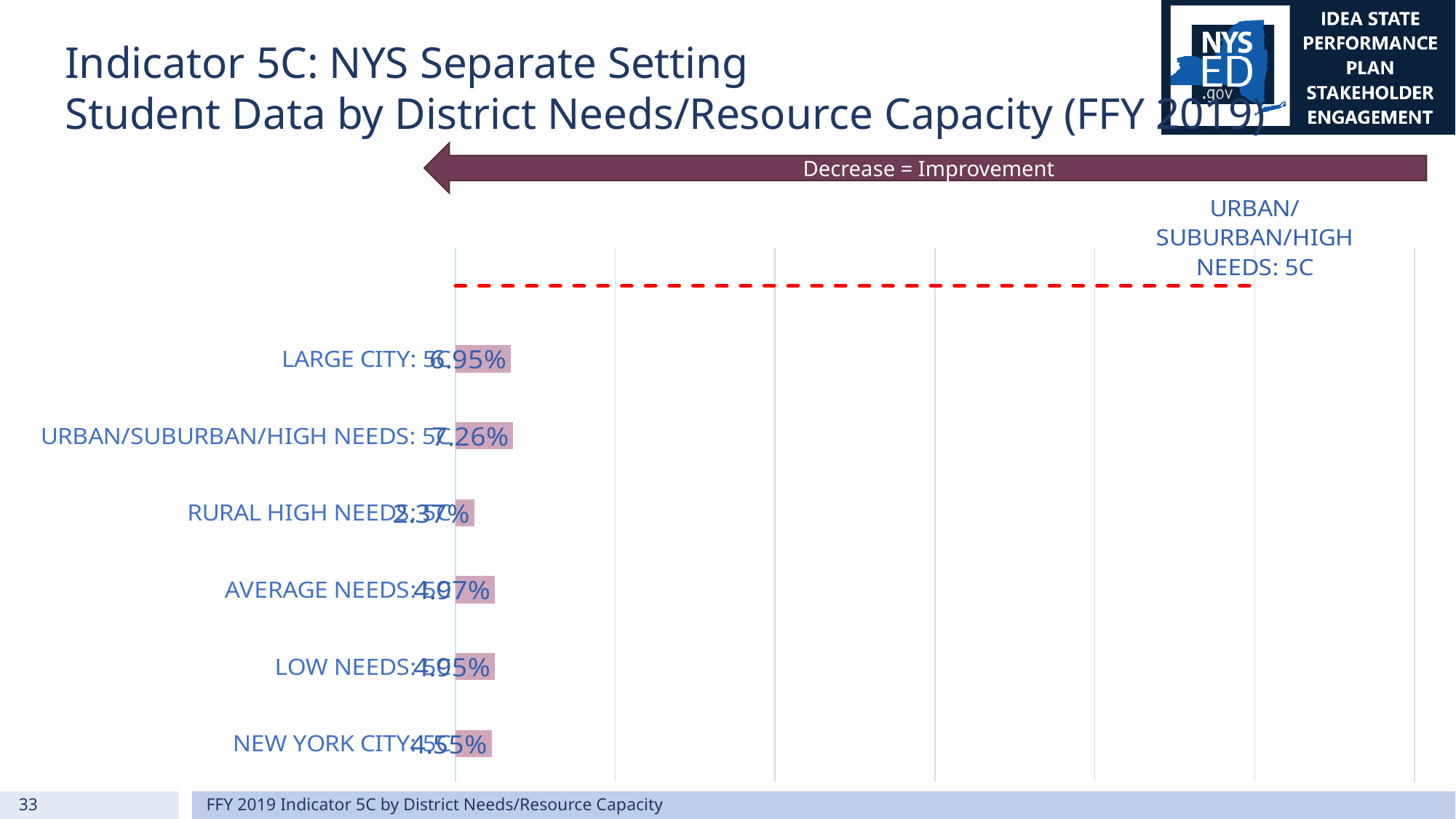
What kind of chart is shown on the slide? bar chart How many categories (district needs/resource capacity groups) are plotted in the chart? 6 Is the bar for RURAL HIGH NEEDS longer or shorter than the bar for URBAN/SUBURBAN/HIGH NEEDS? shorter Which category has the shortest bar in the chart? RURAL HIGH NEEDS According to the arrow above the chart, what does a decrease indicate? Improvement Which category is listed first (at the top) of the chart? LARGE CITY Which category is listed last (at the bottom) of the chart? NEW YORK CITY